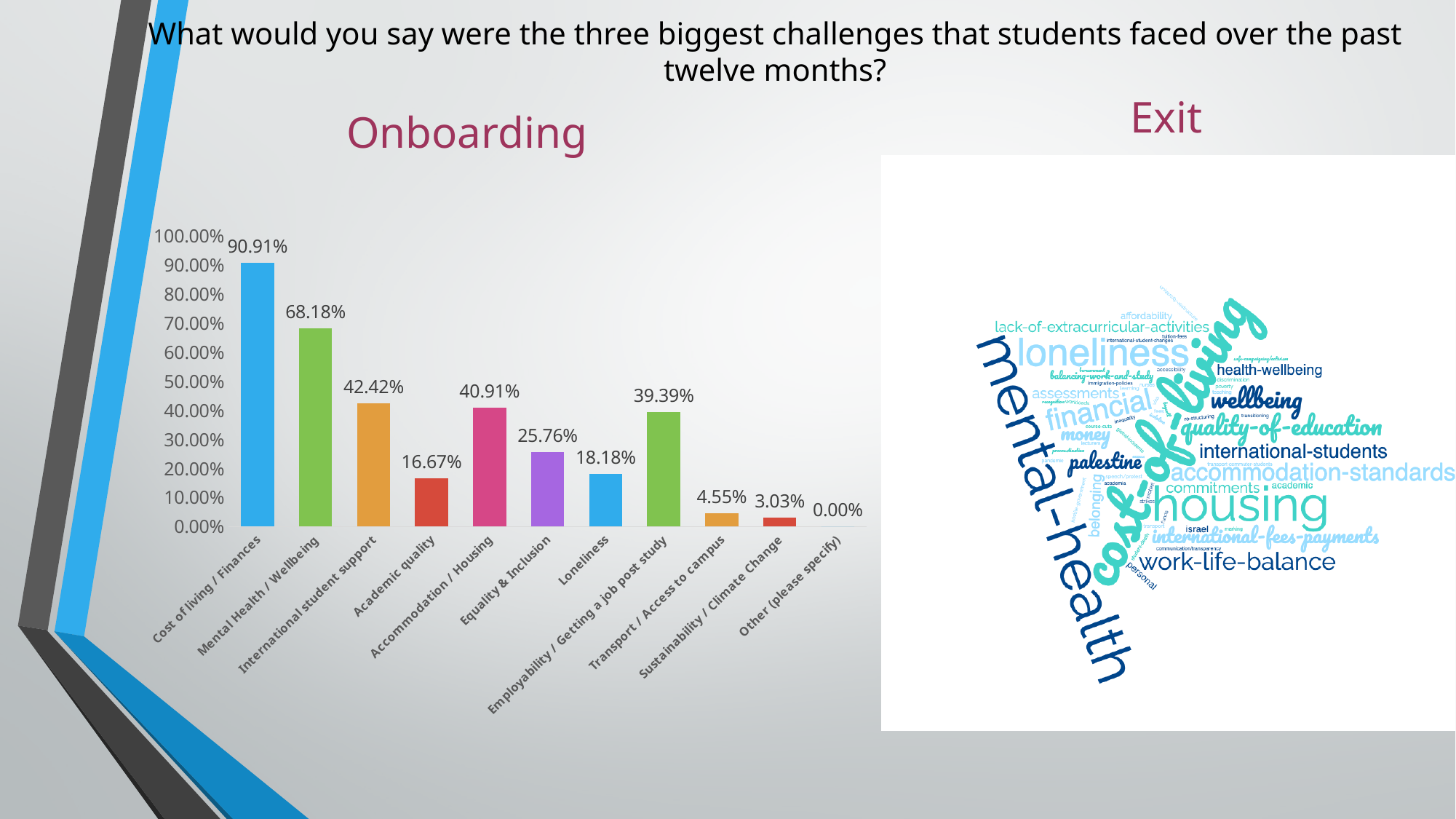
In the Onboarding bar chart, what is the difference between Cost of living / Finances and Mental Health / Wellbeing? 22.73% In the Onboarding bar chart, is the value for Equality & Inclusion greater or less than 30.00%? less In the Onboarding bar chart, what is the value for Mental Health / Wellbeing? 68.18% In the Onboarding bar chart, which is larger: International student support or Employability / Getting a job post study? International student support In the Onboarding bar chart, what is the value for Sustainability / Climate Change? 3.03% In the Onboarding bar chart, what is the value for Loneliness? 18.18% In the Onboarding bar chart, what is the value for Accommodation / Housing? 40.91% In the Onboarding bar chart, what is the value for Cost of living / Finances? 90.91% What kind of chart is the Onboarding chart? Bar chart How many categories are shown in the Onboarding bar chart? 11 In the Onboarding bar chart, which category has the highest value? Cost of living / Finances In the Onboarding bar chart, which category has the lowest value? Other (please specify)